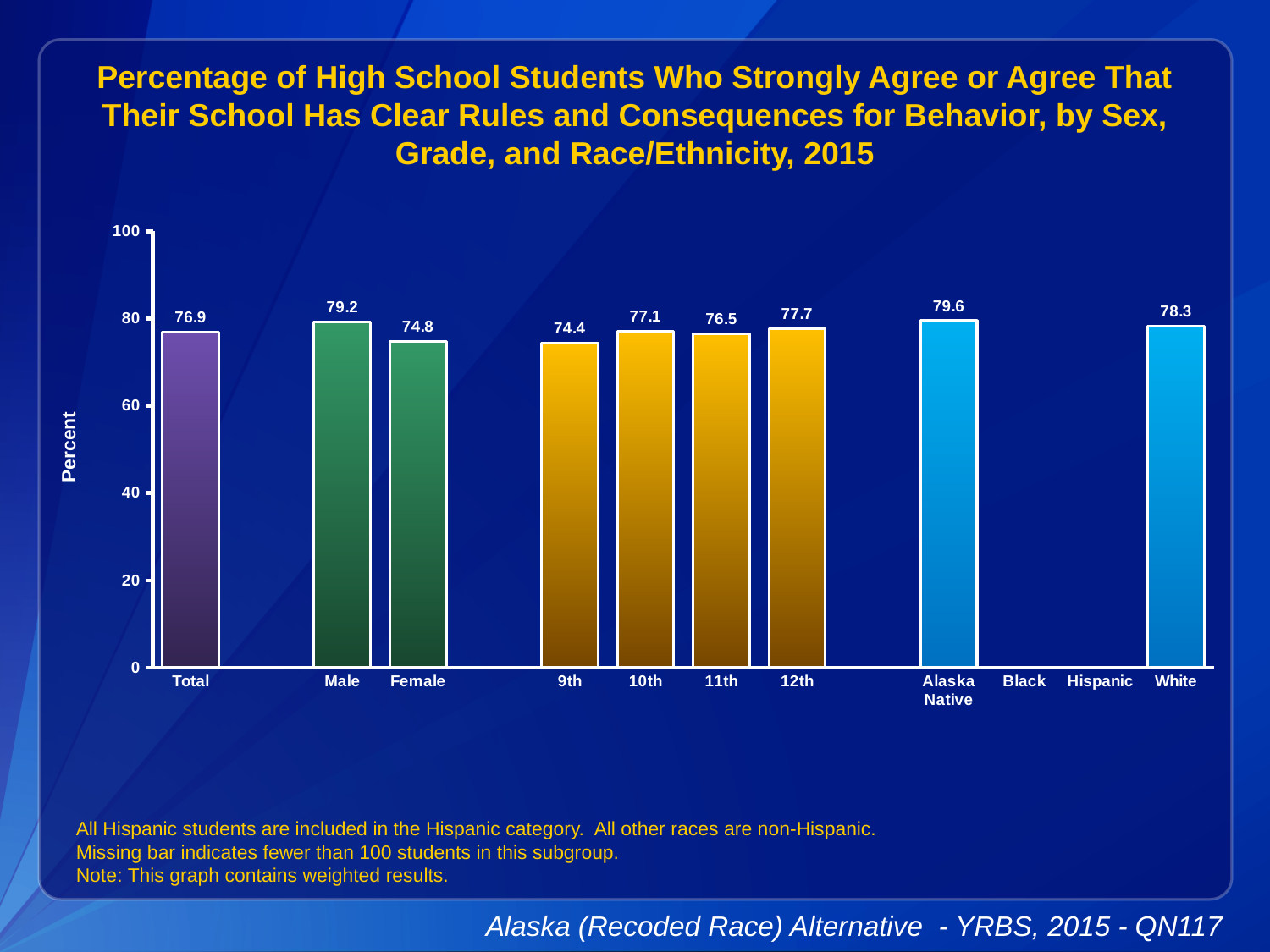
What is the value for 9th grade? 74.4 What is the value for Alaska Native? 79.6 Which category has the highest value? Alaska Native What is the value for Total? 76.9 Is the value for White greater or less than 60? greater What kind of chart is shown? bar chart What is the value for Male? 79.2 What is the difference between the Male and Female values? 4.4 Which is larger, the value for 12th grade or the value for 10th grade? 12th Which categories on the x axis have no bar? Black and Hispanic How many categories on the x axis have a bar plotted? 9 Which category has the lowest value among those with bars? 9th